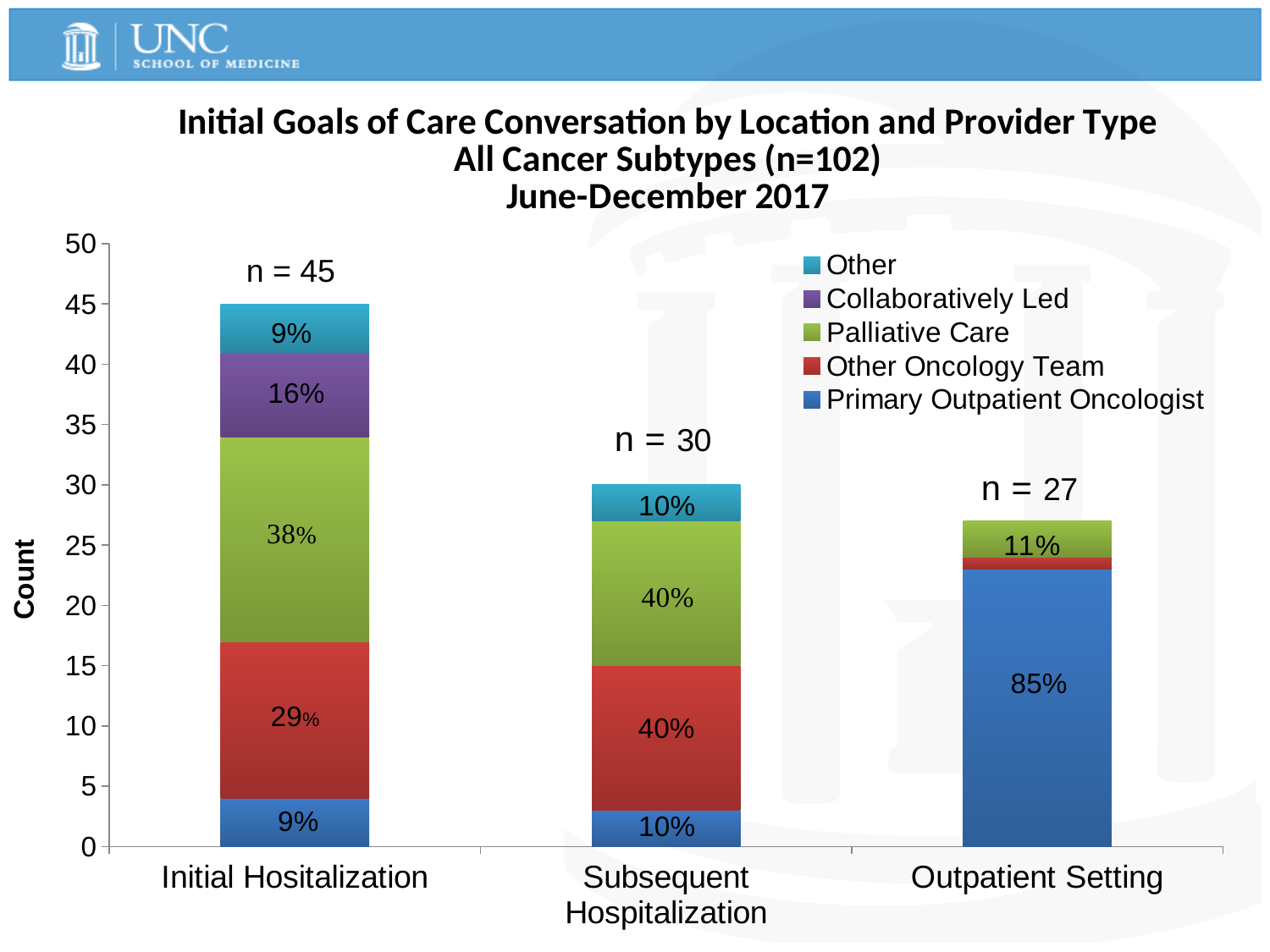
What percentage label is shown for Palliative Care in the Initial Hospitalization bar? 38% Is the count for Primary Outpatient Oncologist in the Outpatient Setting bar greater or less than 20? greater Which location has the highest total count? Initial Hospitalization What percentage label is shown for Primary Outpatient Oncologist in the Outpatient Setting bar? 85% Which location has the lowest total count? Outpatient Setting How many series does the legend list? 5 What type of chart is shown on the slide? Stacked bar chart What percentage label is shown for Other Oncology Team in the Subsequent Hospitalization bar? 40% What is the total n for the Initial Hospitalization bar? 45 What is the difference between the n for Initial Hospitalization and the n for Subsequent Hospitalization? 15 What is the total n for the Outpatient Setting bar? 27 How many location categories are shown on the x axis? 3